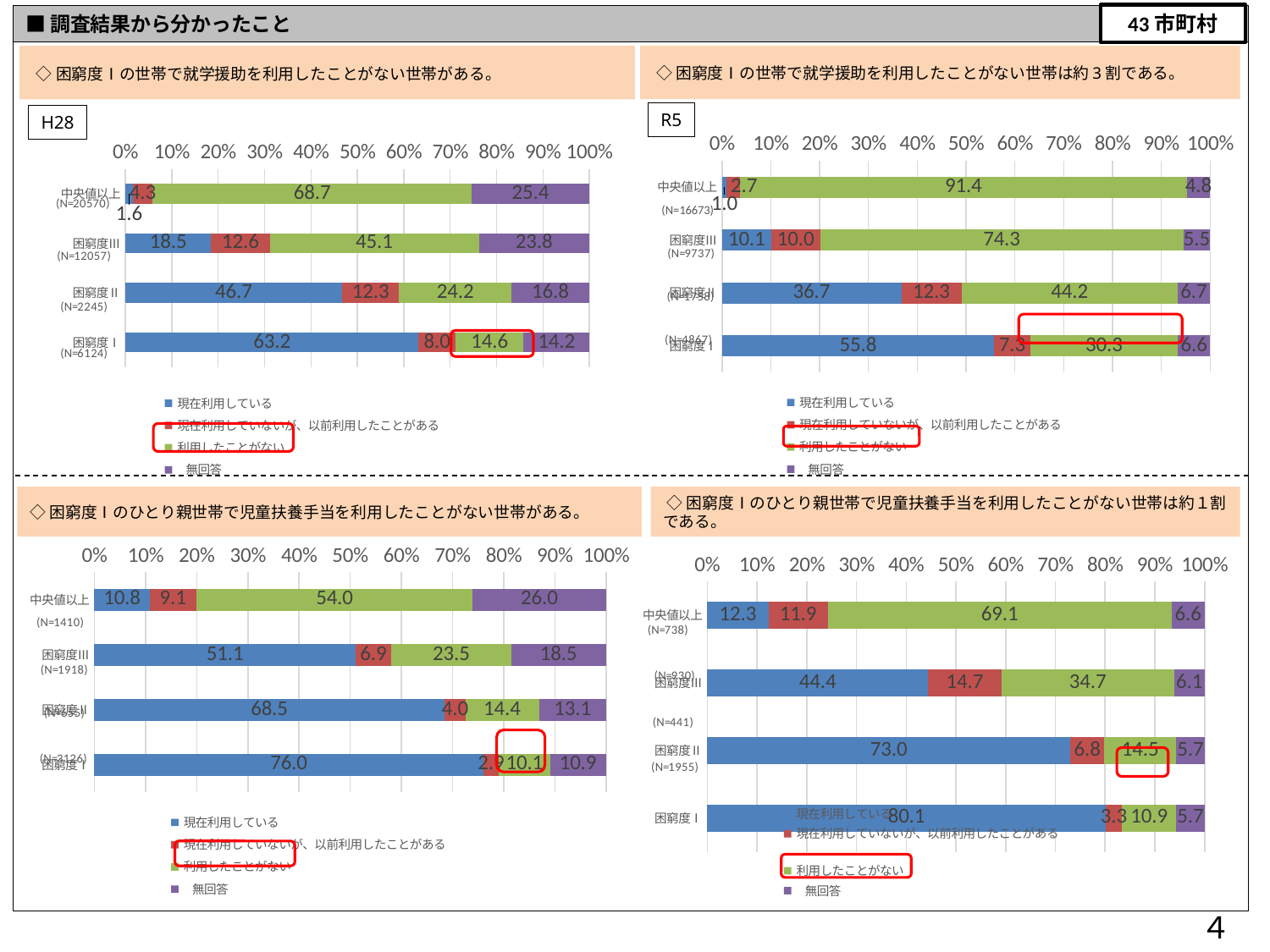
In the top-right R5 chart, which category has the highest value for 現在利用している? 困窮度Ⅰ In the bottom-left chart, what is the value of 無回答 for 中央値以上? 26.0 What kind of chart is the bottom-left chart? Stacked bar chart How many categories are shown on the y axis of the top-left H28 chart? 4 How many series does the legend of the top-left H28 chart list? 4 In the top-right R5 chart, what is the value of 利用したことがない for 困窮度Ⅰ? 30.3 In the bottom-right chart, what is the value of 現在利用している for 困窮度Ⅰ? 80.1 In the top-left H28 chart, which category has the lowest value for 現在利用している? 中央値以上 In the top-left H28 chart, what is the value of 利用したことがない for 困窮度Ⅰ? 14.6 In the bottom-left chart, what is the difference between the 現在利用している values for 困窮度Ⅰ and 困窮度Ⅱ? 7.5 In the bottom-right chart, which is larger: the 利用したことがない value for 困窮度Ⅲ or for 中央値以上? 中央値以上 In the top-right R5 chart, what is the value of 現在利用している for 困窮度Ⅱ? 36.7